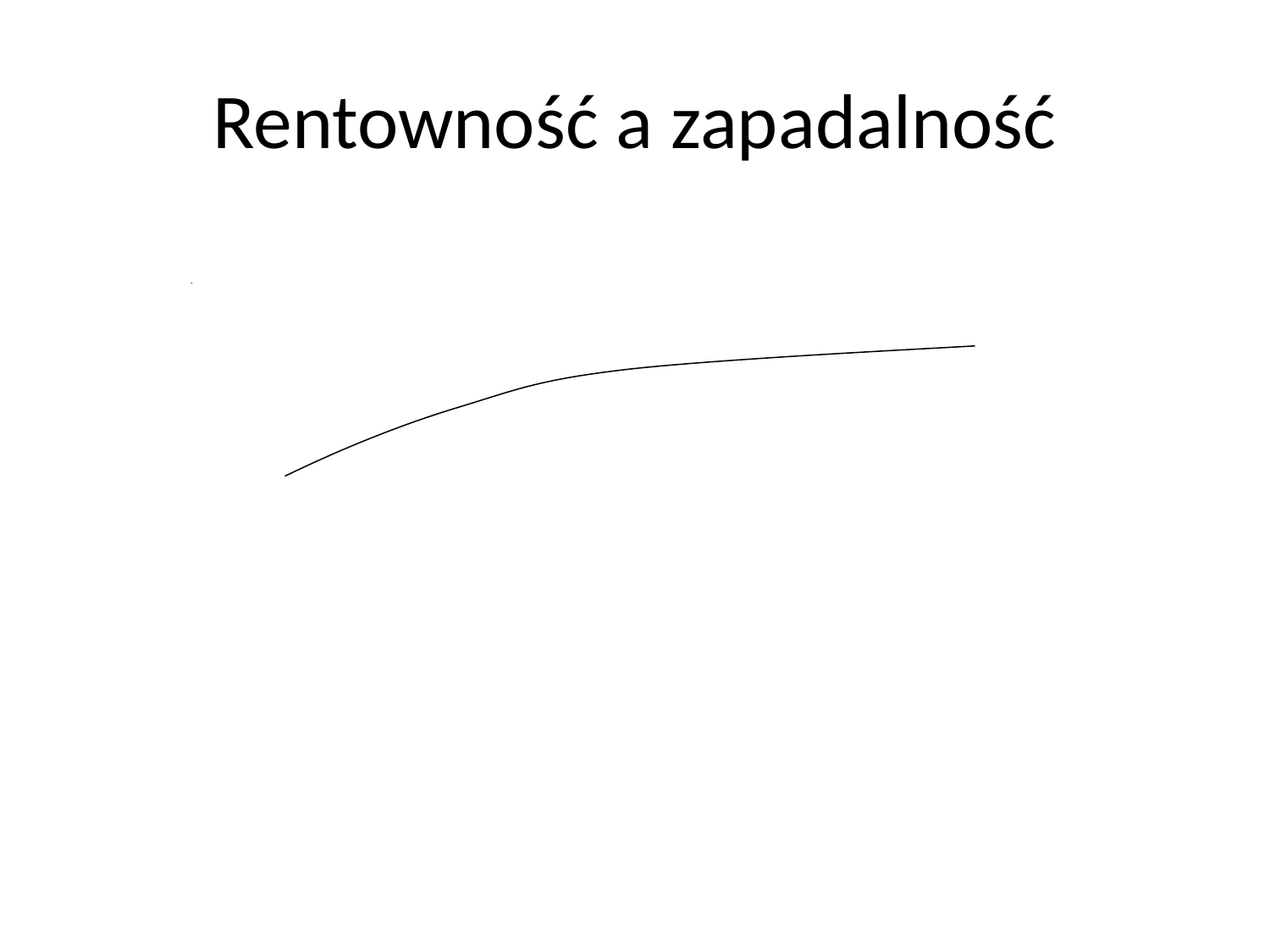
What is the title of the slide containing the chart? Rentowność a zapadalność Does the chart display any axis labels or data labels? No How many lines are plotted on the chart? 1 What kind of chart is shown on the slide? line chart Does the plotted line rise or fall from left to right? rises